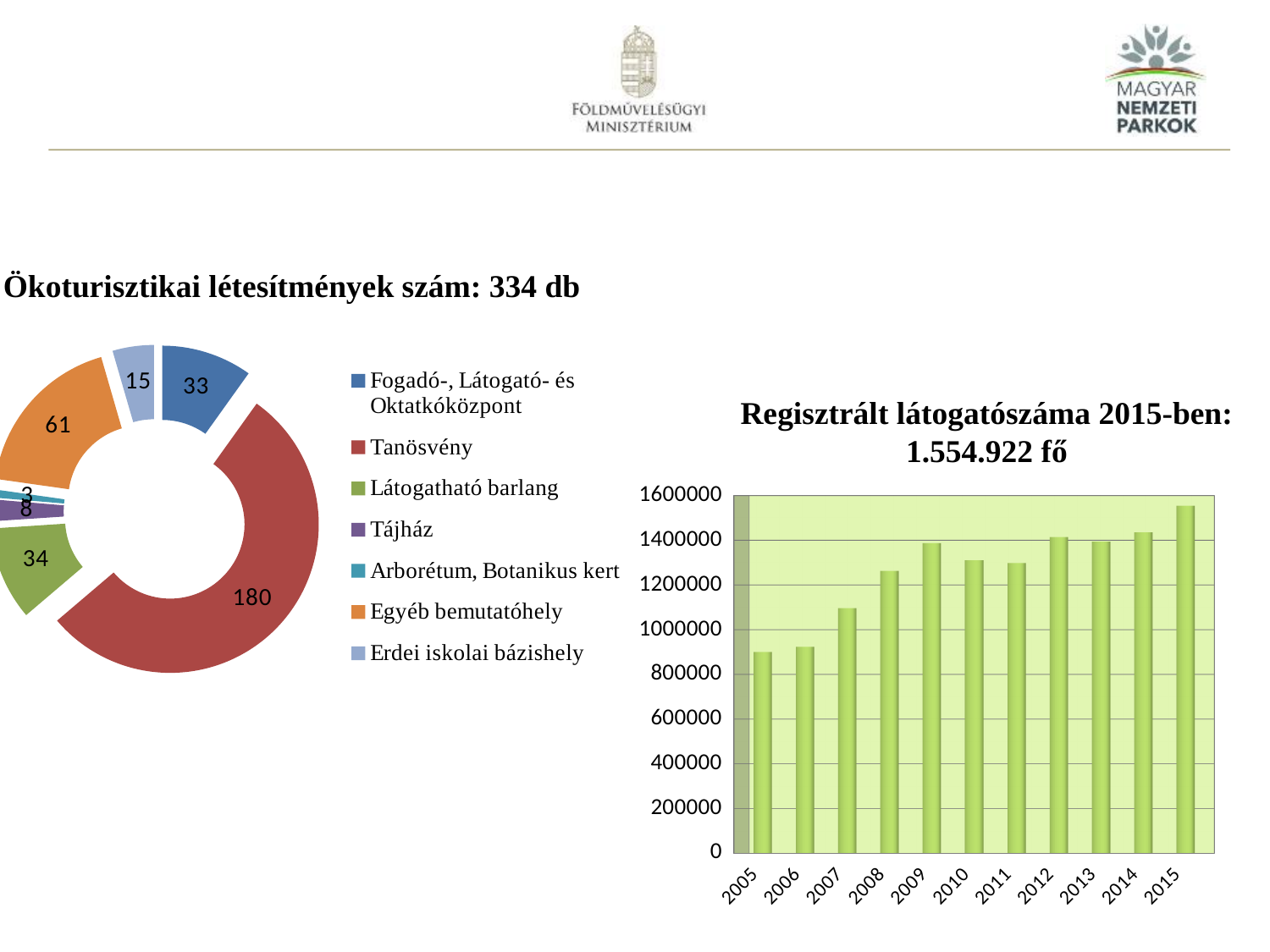
On the doughnut chart on the left, which is larger: Fogadó-, Látogató- és Oktatkóközpont or Erdei iskolai bázishely? Fogadó-, Látogató- és Oktatkóközpont On the bar chart on the right, which year has the highest value? 2015 On the doughnut chart on the left, which category has the smallest value? Arborétum, Botanikus kert On the bar chart on the right, is the value for 2005 greater or less than 1000000? less On the doughnut chart on the left, how many Tanösvény facilities are there? 180 On the doughnut chart on the left, what is the value for Egyéb bemutatóhely? 61 What kind of chart is the 'Regisztrált látogatószáma 2015-ben' chart on the right? bar chart On the doughnut chart on the left, what is the difference between the values for Egyéb bemutatóhely and Látogatható barlang? 27 On the doughnut chart on the left, how many categories does the legend list? 7 On the bar chart on the right, is the value for 2015 greater or less than 1400000? greater On the bar chart on the right, how many years are shown on the x axis? 11 On the doughnut chart on the left, which category has the largest value? Tanösvény